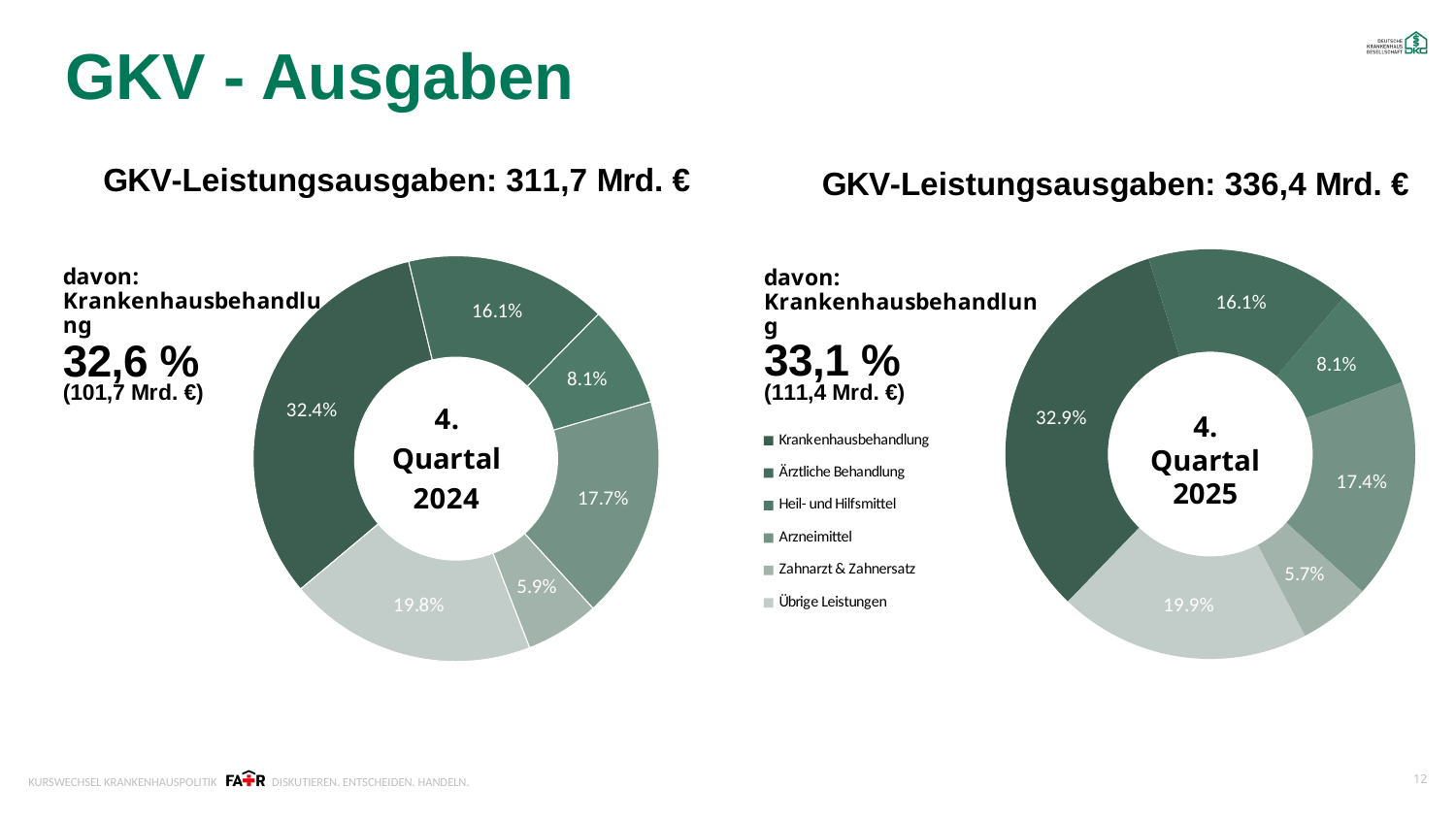
In the 4. Quartal 2025 chart, what share is shown for Heil- und Hilfsmittel? 8.1% In the 4. Quartal 2024 chart, what is the share of the smallest slice? 5.9% What kind of chart is used for 4. Quartal 2024? Donut (pie) chart In the 4. Quartal 2024 chart, what share is shown for Übrige Leistungen? 19.8% In the 4. Quartal 2025 chart, what share is shown for the largest slice? 32.9% In the 4. Quartal 2025 chart, what share is shown for Arzneimittel? 17.4% In the 4. Quartal 2024 chart, what is the difference between the Arzneimittel slice (17.7%) and the Ärztliche Behandlung slice (16.1%)? 1.6% How many entries does the legend list? 6 How many slices does the 4. Quartal 2025 chart have? 6 Which is larger: the Übrige Leistungen share in the 4. Quartal 2024 chart or in the 4. Quartal 2025 chart? 4. Quartal 2025 (19.9%) In the 4. Quartal 2024 chart, what share is shown for the largest slice? 32.4% In the 4. Quartal 2025 chart, what is the share of the smallest slice? 5.7%